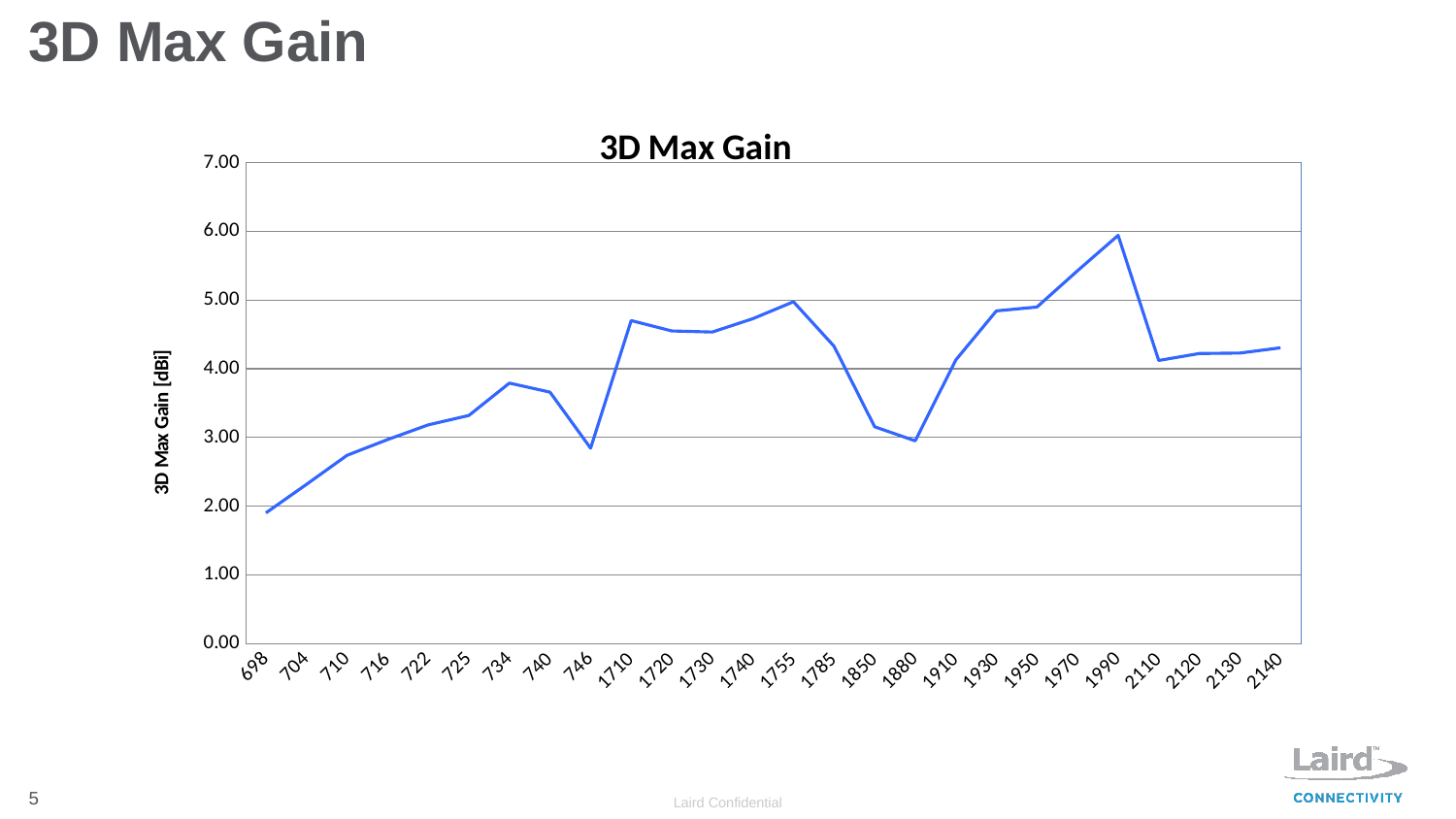
What is the label of the vertical axis? 3D Max Gain [dBi] At which x-axis category does the 3D Max Gain reach its highest value? 1990 Is the value at 698 greater or less than 2.00? less Which has the larger 3D Max Gain, 698 or 1710? 1710 Is the value at 1710 greater or less than 4.00? greater Does the 3D Max Gain rise or fall from 698 to 734? rise At which x-axis category is the 3D Max Gain lowest? 698 How many data points are plotted along the x axis? 26 Is the value at 1990 greater or less than 5.00? greater Which has the larger 3D Max Gain, 1990 or 2110? 1990 What kind of chart is shown on the slide? line chart